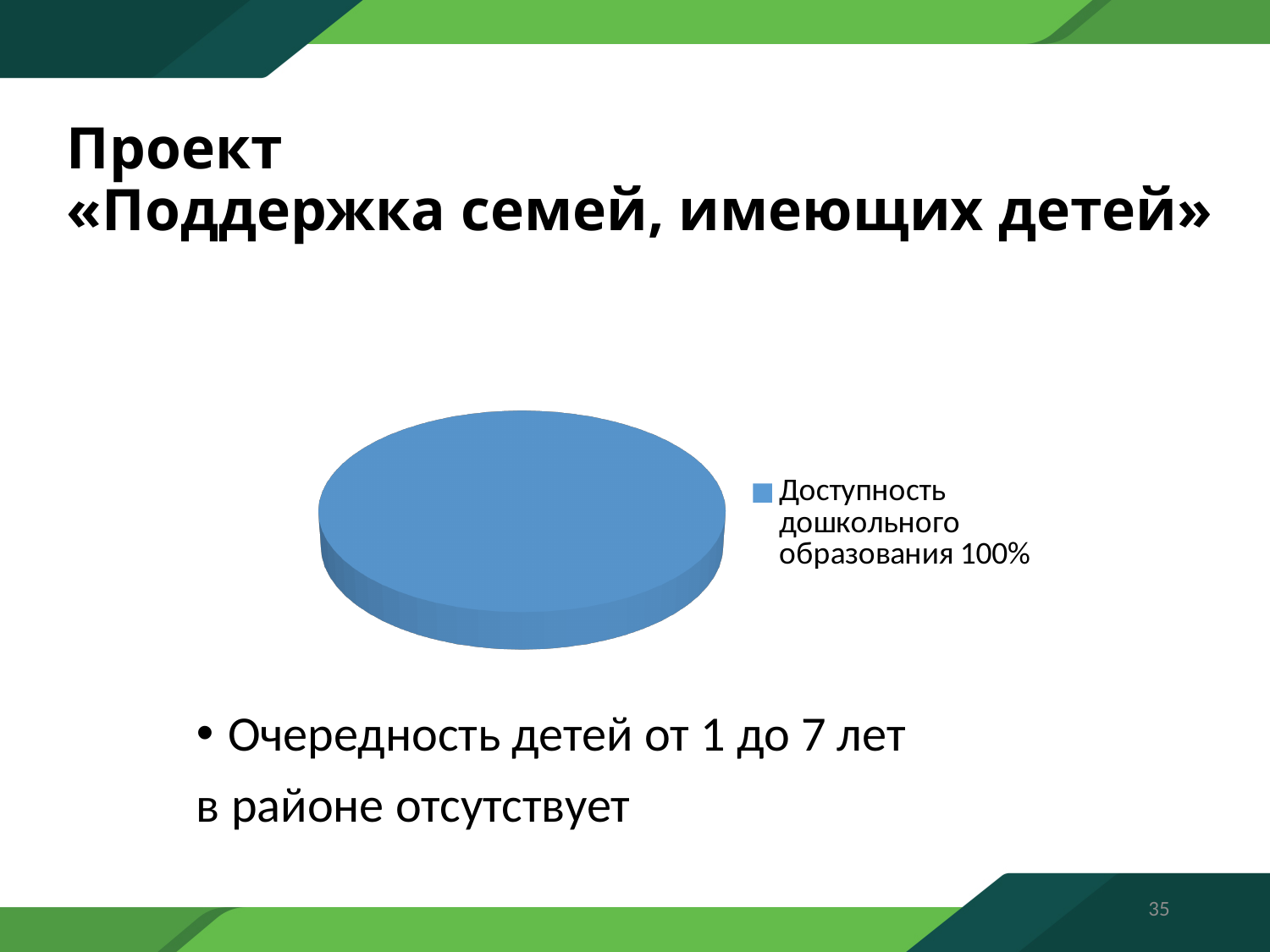
What share of the pie does the slice "Доступность дошкольного образования" represent? 100% How many slices does the pie chart have? 1 How many entries does the legend of the pie chart list? 1 What is the legend entry shown next to the pie chart? Доступность дошкольного образования 100% What kind of chart is shown on the slide? pie chart What colour is the single slice of the pie chart? blue